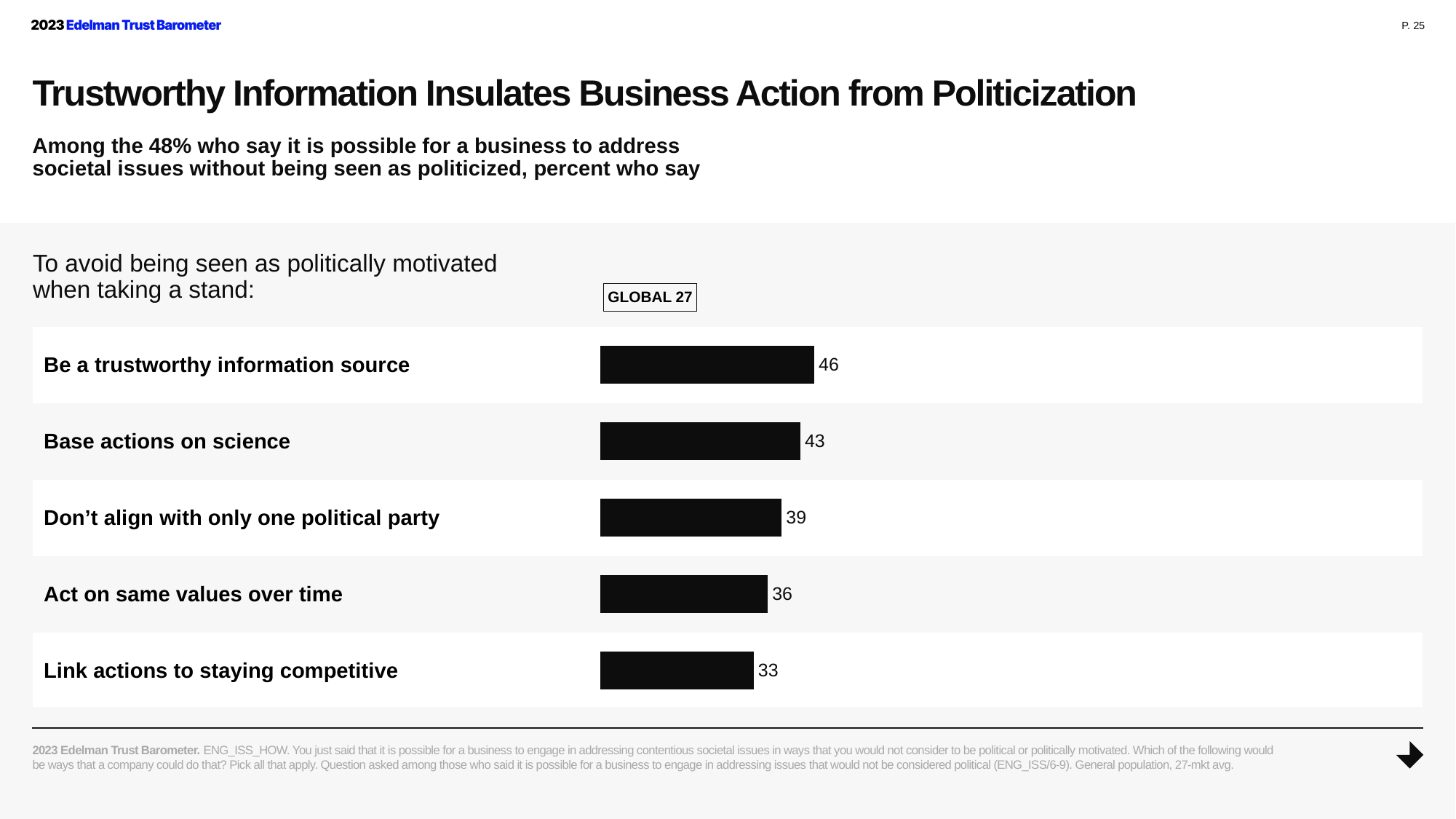
Which is larger: the value for "Base actions on science" or "Act on same values over time"? Base actions on science How many categories are shown in the chart? 5 What is the value for "Be a trustworthy information source"? 46 What is the value for "Act on same values over time"? 36 What is the value for "Don't align with only one political party"? 39 What is the label shown in the box above the bars? GLOBAL 27 What is the value for "Link actions to staying competitive"? 33 Which category has the lowest value? Link actions to staying competitive What is the value for "Base actions on science"? 43 What kind of chart is shown on the slide? Bar chart What is the difference between the values for "Be a trustworthy information source" and "Link actions to staying competitive"? 13 Which category has the highest value? Be a trustworthy information source